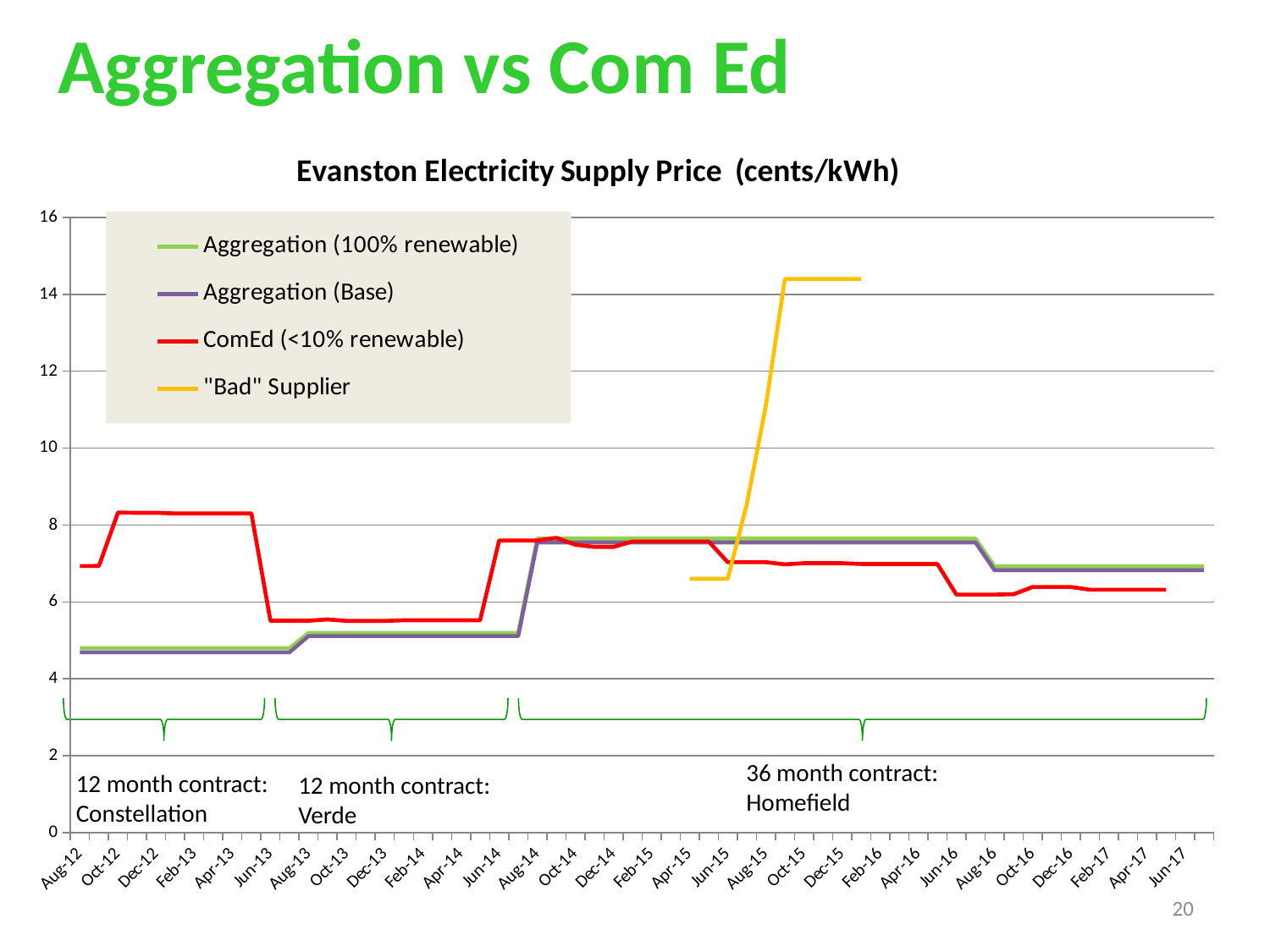
Is the value for ComEd (<10% renewable) in Dec-12 greater or less than 8? greater What kind of chart is shown on the slide? line chart Which series reaches the highest value on the chart? "Bad" Supplier Does the "Bad" Supplier series rise or fall between Jun-15 and Oct-15? rise In Dec-12, which is higher: ComEd (<10% renewable) or Aggregation (Base)? ComEd (<10% renewable) Which series is drawn in red? ComEd (<10% renewable) Is the value for Aggregation (Base) in Aug-12 greater or less than 6? less In Dec-15, which is higher: "Bad" Supplier or ComEd (<10% renewable)? "Bad" Supplier Is the value for Aggregation (100% renewable) in Oct-15 greater or less than 8? less What is the title of the chart? Evanston Electricity Supply Price (cents/kWh) How many series does the legend list? 4